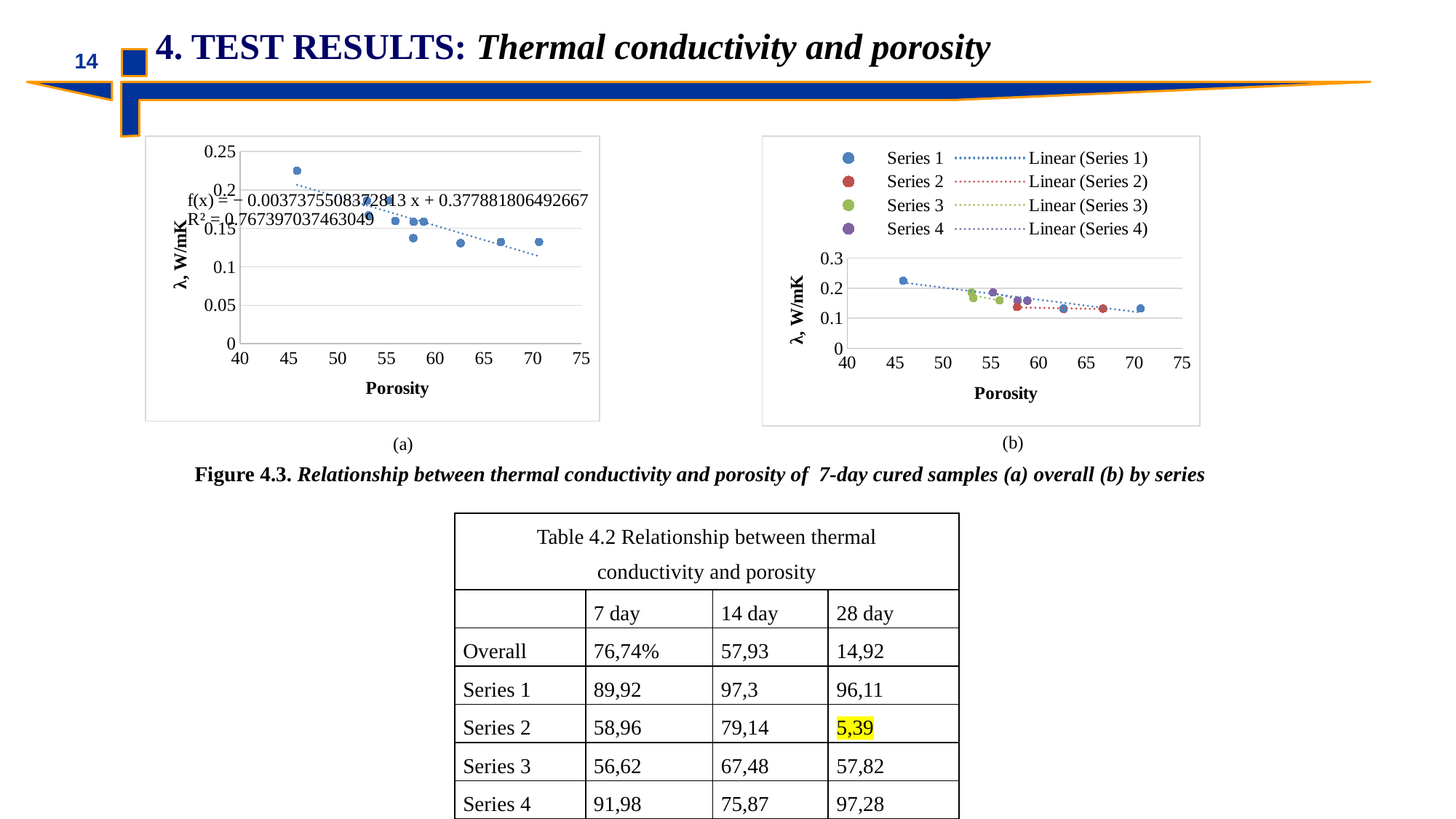
In chart (b), is the Series 1 point at porosity around 46 greater or less than 0.2? greater In chart (a), which point has the larger value: the one at the lowest porosity or the one at the highest porosity? the one at the lowest porosity What R² value is printed on chart (a)? 0.767397037463049 In chart (b), how many data series named 'Series 1' to 'Series 4' does the legend list? 4 What kind of chart is chart (a) on the left? scatter chart In chart (a), is the value of the rightmost point (porosity around 70) greater or less than 0.15? less In chart (a), is the value of the point at the lowest porosity (around 46) greater or less than 0.2? greater In chart (a), do the thermal conductivity values rise or fall as porosity increases along the x axis? fall What is the x-axis title of chart (a)? Porosity